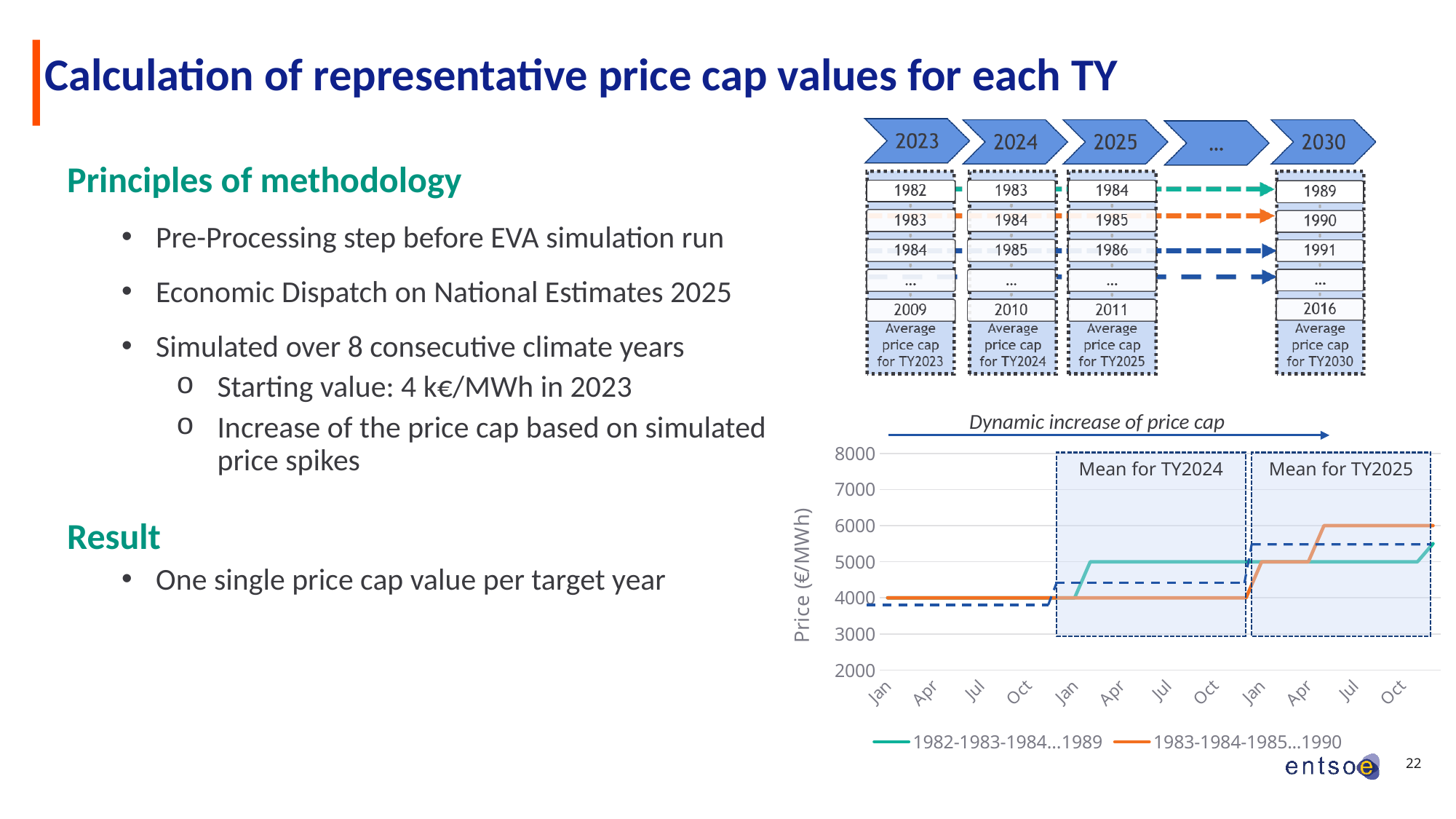
In the price chart, at the final Oct, which series is higher: 1982-1983-1984...1989 or 1983-1984-1985...1990? 1983-1984-1985...1990 Do the series in the price chart generally rise or fall along the x axis? rise How many series does the legend of the price chart list? 2 What kind of chart is shown at the bottom right of the slide? line chart How many month labels are shown on the x axis of the price chart? 12 In the price chart, is the value of the 1982-1983-1984...1989 series at the second Jul greater or less than 4000? greater What is the y-axis title of the price chart? Price (€/MWh) In the price chart, is the value of the 1983-1984-1985...1990 series at the first Oct greater or less than 5000? less In the price chart, is the value of the 1983-1984-1985...1990 series at the final Oct greater or less than 5000? greater What is the highest tick value shown on the y axis of the price chart? 8000 What are the two series names in the legend of the price chart? 1982-1983-1984...1989 and 1983-1984-1985...1990